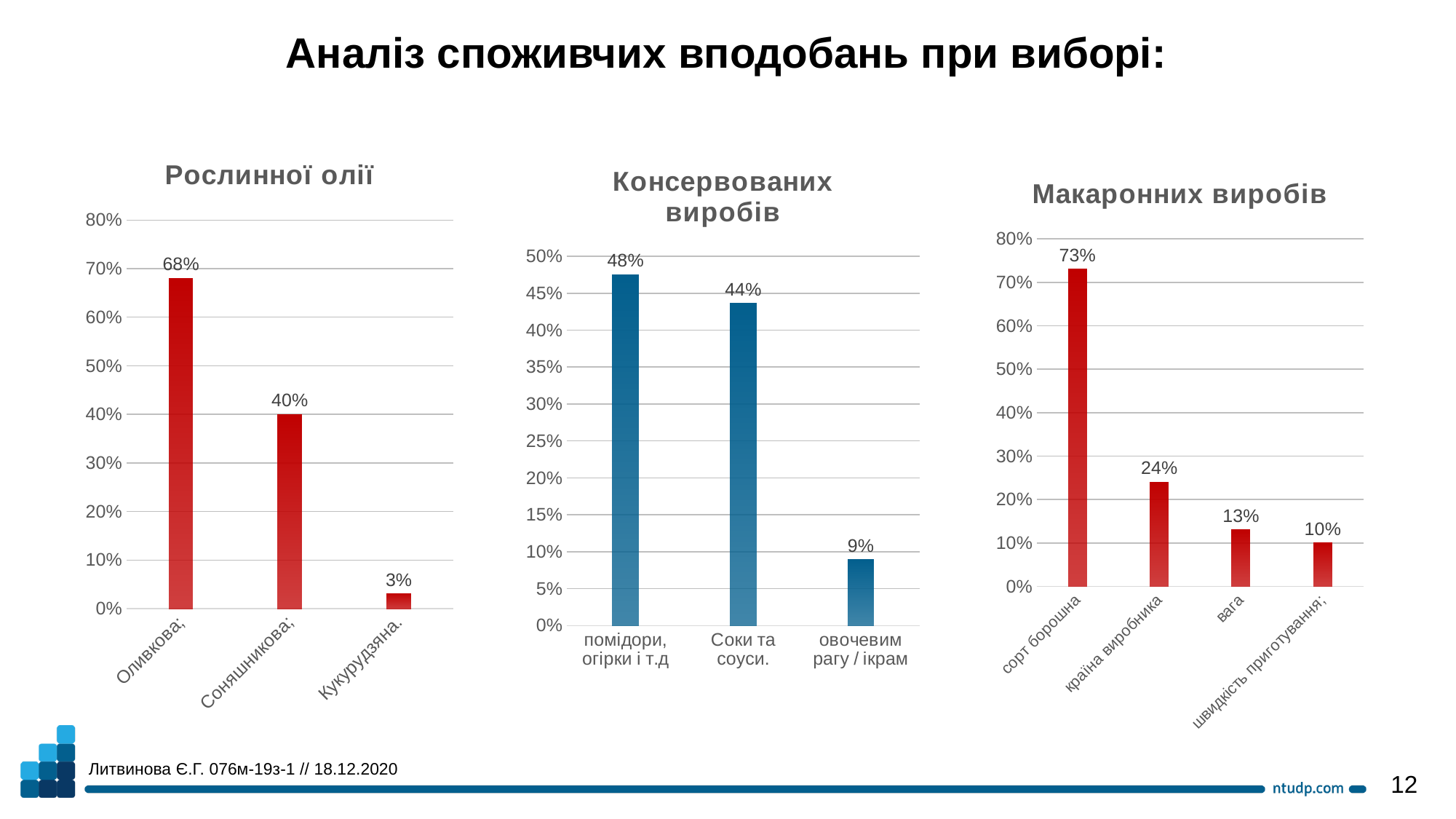
In the 'Макаронних виробів' chart, what is the value for 'країна виробника'? 24% In the 'Макаронних виробів' chart, what is the difference between 'вага' and 'швидкість приготування'? 3% In the 'Макаронних виробів' chart, how many categories are shown? 4 In the 'Рослинної олії' chart, which category has the lowest value? Кукурудзяна In the 'Рослинної олії' chart, what is the value for Оливкова? 68% In the 'Консервованих виробів' chart, how many categories are shown? 3 In the 'Консервованих виробів' chart, which category has the highest value? помідори, огірки і т.д In the 'Макаронних виробів' chart, do the values rise or fall from left to right? Fall In the 'Консервованих виробів' chart, what is the value for 'Соки та соуси'? 44% In the 'Рослинної олії' chart, what is the difference between Оливкова and Соняшникова? 28% In the 'Макаронних виробів' chart, which category has the highest value? сорт борошна What type of chart is the 'Консервованих виробів' chart? Bar chart